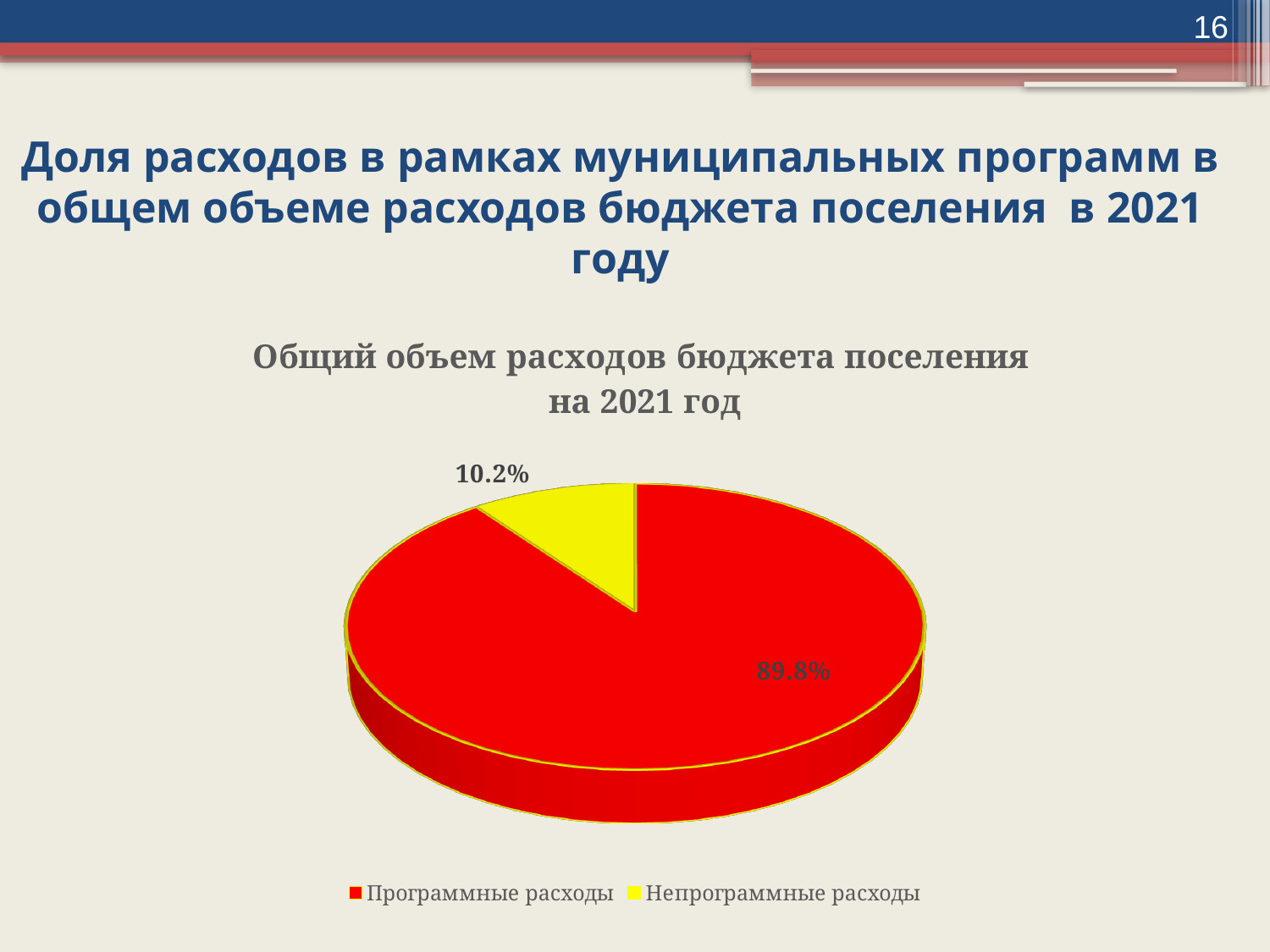
What colour is the slice for Непрограммные расходы? Yellow What is the share of Непрограммные расходы in the pie chart? 10.2% What kind of chart is shown on the slide? Pie chart Which is larger: the share of Программные расходы or the share of Непрограммные расходы? Программные расходы What is the title of the pie chart? Общий объем расходов бюджета поселения на 2021 год How many entries does the legend list? 2 Which category has the smallest slice of the pie? Непрограммные расходы How many slices does the pie chart have? 2 What is the share of Программные расходы in the pie chart? 89.8% What is the difference in percentage points between Программные расходы and Непрограммные расходы? 79.6 What is the total of the two slices shown in the pie chart? 100% Which category has the largest slice of the pie? Программные расходы